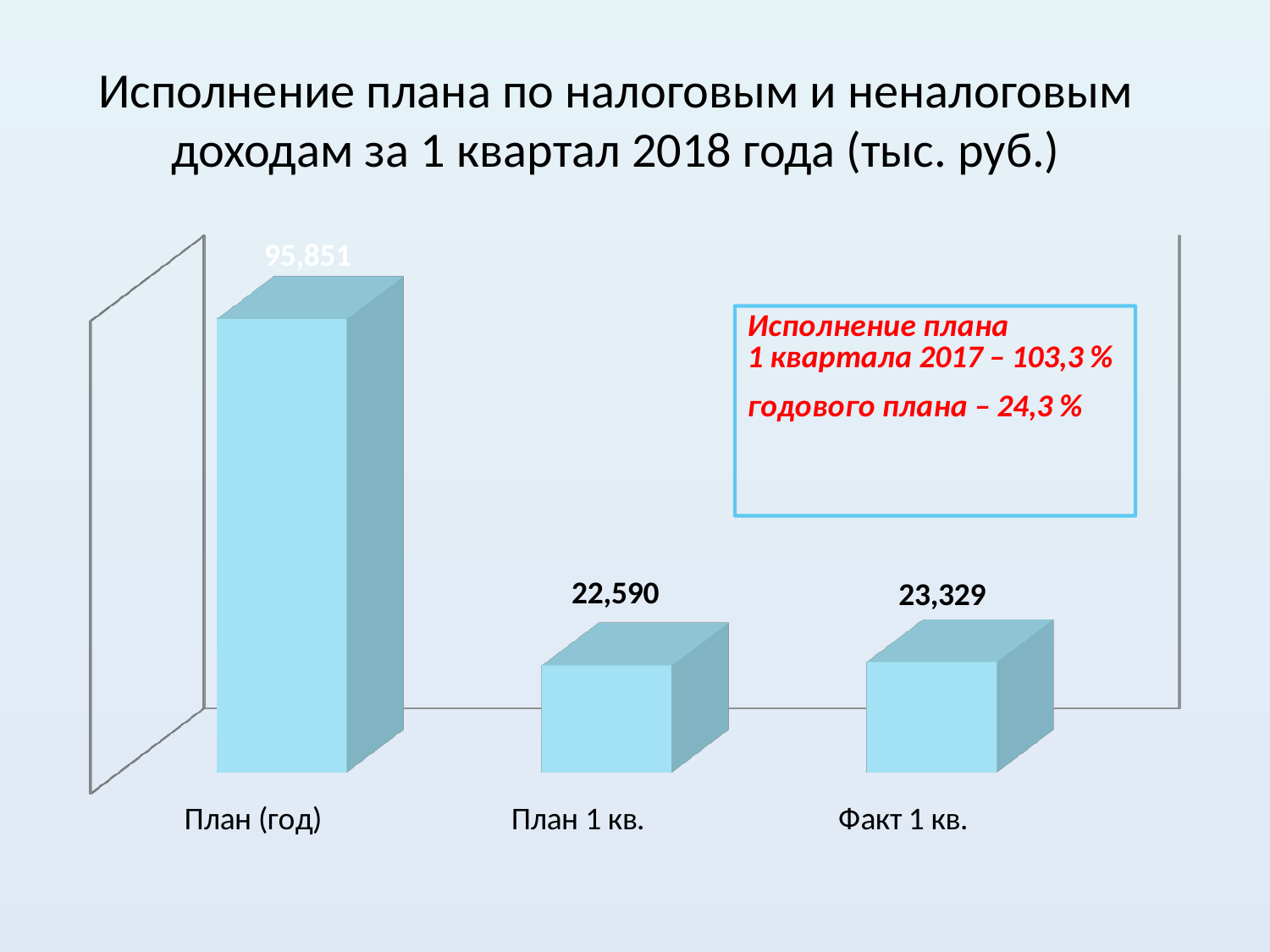
How many categories are shown in the chart? 3 What is the value for План 1 кв.? 22,590 What unit of measurement is given in the chart title? тыс. руб. What is the difference between План (год) and План 1 кв.? 73,261 Which category has the highest value? План (год) What is the value for План (год)? 95,851 What kind of chart is shown on the slide? Bar chart According to the text box, what percentage of the annual plan was fulfilled? 24,3 % What is the difference between Факт 1 кв. and План 1 кв.? 739 What is the value for Факт 1 кв.? 23,329 Which is larger, План 1 кв. or Факт 1 кв.? Факт 1 кв. Which category has the lowest value? План 1 кв.